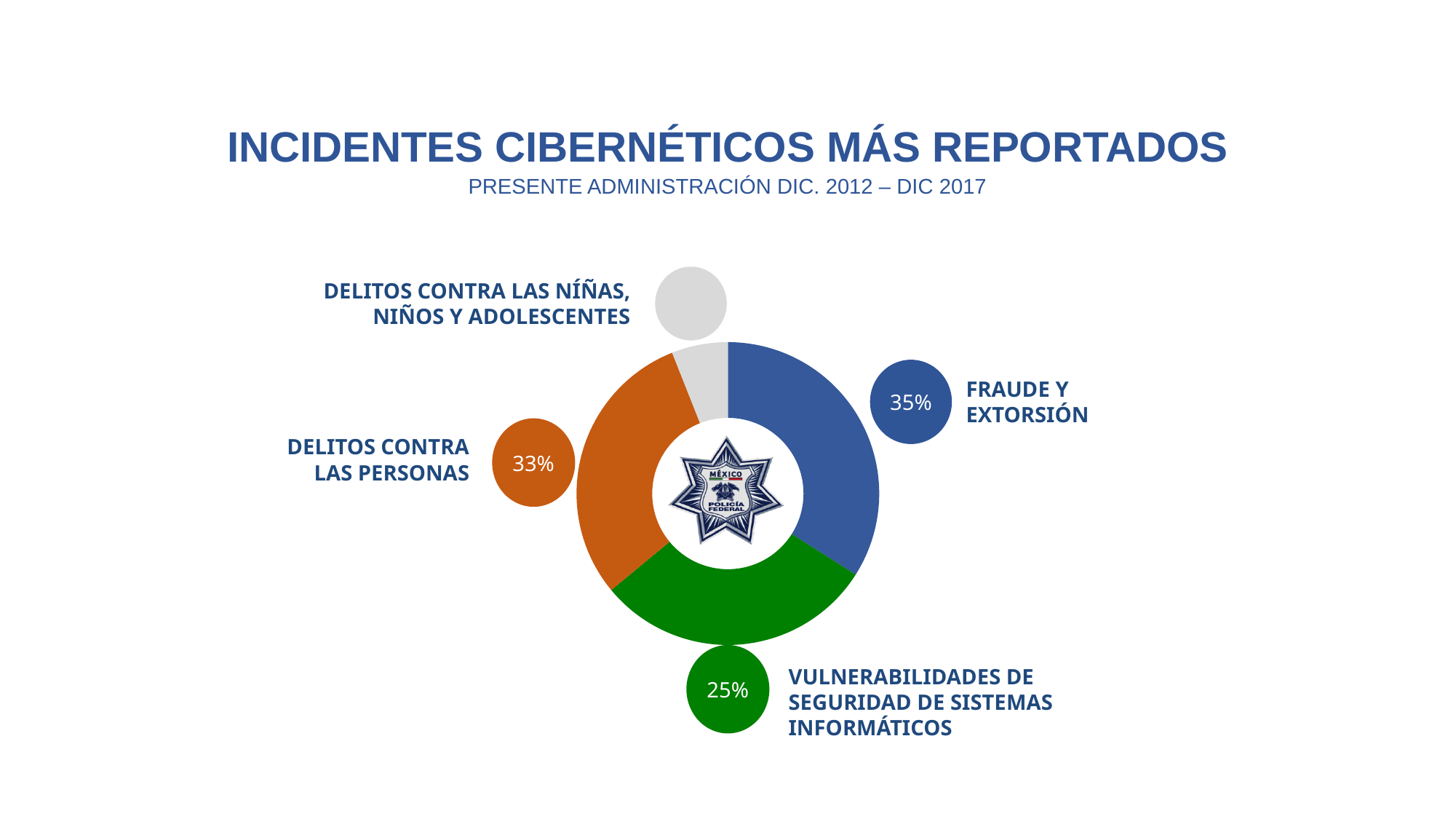
What kind of chart is shown on the slide? Pie (donut) chart What percentage is shown for Vulnerabilidades de seguridad de sistemas informáticos? 25% What percentage of reported cyber incidents is attributed to Fraude y Extorsión? 35% Which category has the smallest slice of the chart? Delitos contra las niñas, niños y adolescentes Which is larger: the share for Fraude y Extorsión or the share for Vulnerabilidades de seguridad de sistemas informáticos? Fraude y Extorsión What is the difference in percentage points between Fraude y Extorsión and Delitos contra las personas? 2 percentage points What time period does the subtitle say the chart covers? Dic. 2012 – Dic 2017 What is the title of the chart on the slide? INCIDENTES CIBERNÉTICOS MÁS REPORTADOS Which category has the largest share of the chart? Fraude y Extorsión What colour is the slice for Vulnerabilidades de seguridad de sistemas informáticos? Green What percentage is shown for Delitos contra las personas? 33% How many categories are shown in the chart? 4